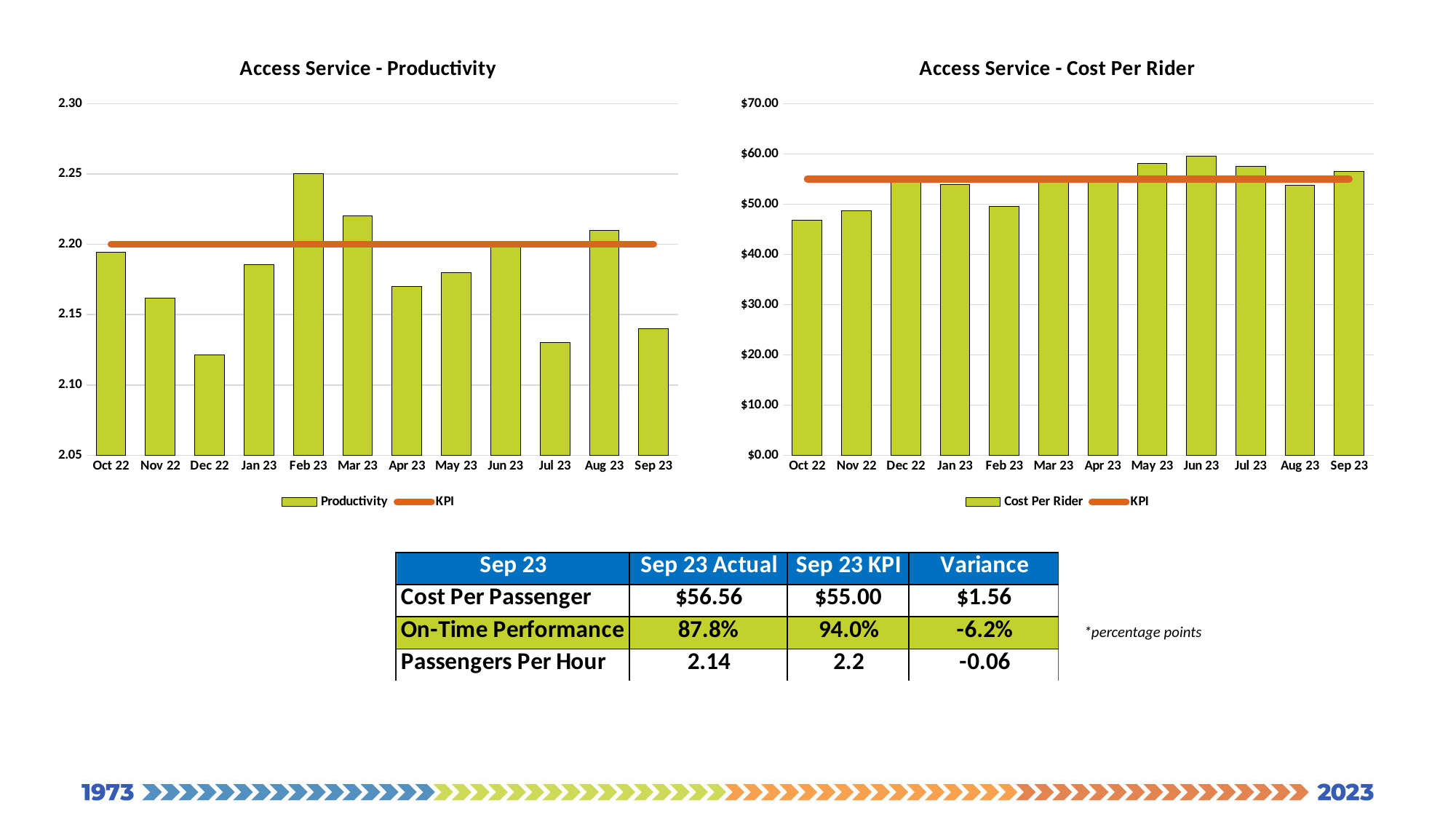
In the 'Access Service - Productivity' chart, which is larger, the bar for Feb 23 or the bar for Mar 23? Feb 23 How many series does the legend of the 'Access Service - Productivity' chart list? 2 In the 'Access Service - Productivity' chart, which month has the highest productivity bar? Feb 23 In the 'Access Service - Cost Per Rider' chart, which is larger, the bar for Nov 22 or the bar for Jun 23? Jun 23 In the 'Access Service - Productivity' chart, is the value for Feb 23 greater or less than 2.20? greater In the 'Access Service - Cost Per Rider' chart, which month has the lowest cost per rider? Oct 22 How many months are shown on the x axis of the 'Access Service - Productivity' chart? 12 In the 'Access Service - Productivity' chart, is the value for Dec 22 greater or less than 2.15? less In the 'Access Service - Cost Per Rider' chart, which month has the highest cost per rider? Jun 23 In the 'Access Service - Cost Per Rider' chart, is the value for Oct 22 greater or less than $50.00? less What kind of chart is the 'Access Service - Productivity' chart? bar chart What are the two legend entries of the 'Access Service - Cost Per Rider' chart? Cost Per Rider and KPI